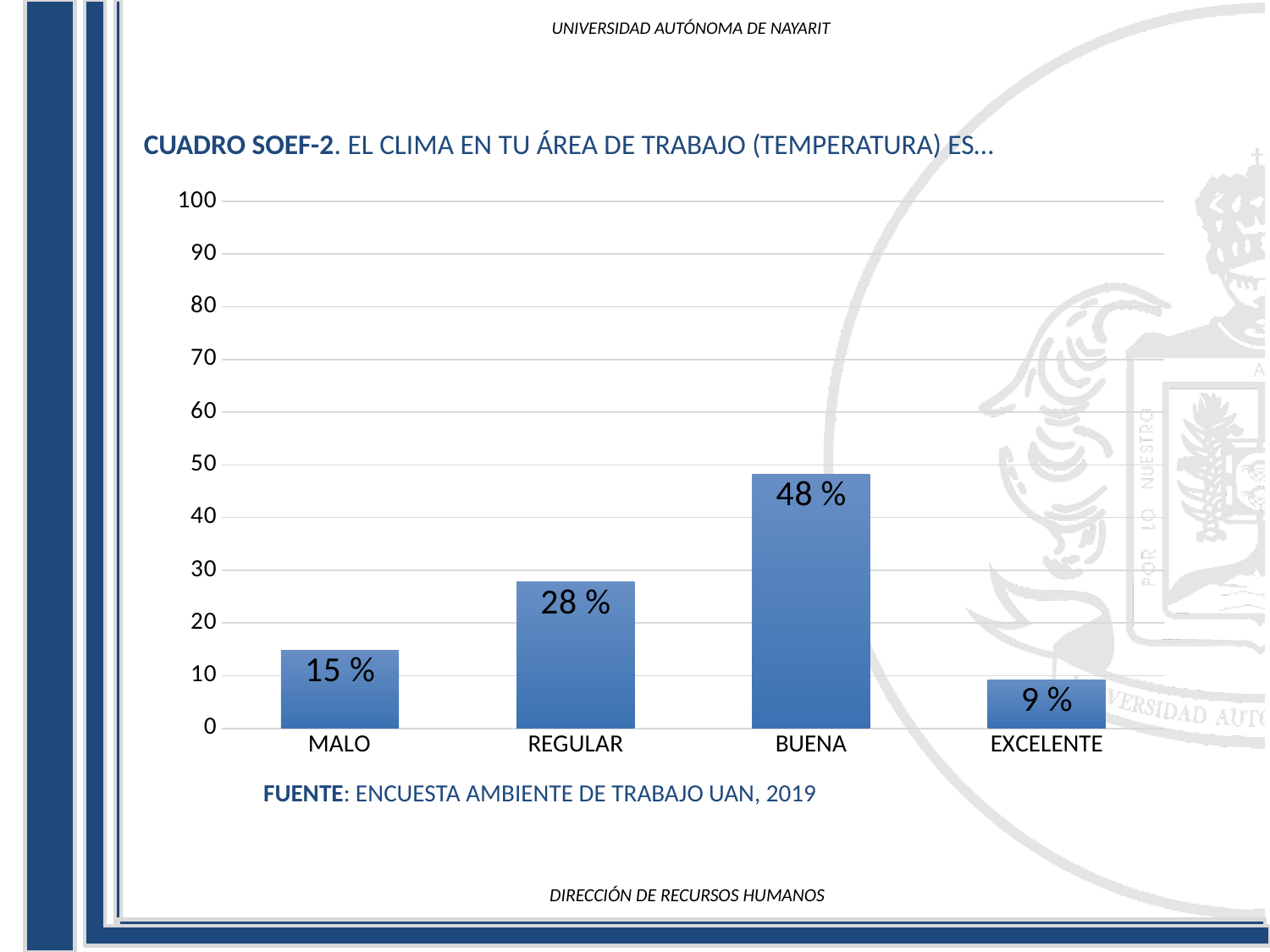
Which category has the highest value? BUENA What is the value for BUENA? 48 % What kind of chart is shown on the slide? bar chart Which is larger, the value for MALO or the value for REGULAR? REGULAR What is the value for EXCELENTE? 9 % What is the maximum value shown on the y axis? 100 Is the value for REGULAR greater or less than 30? less Which category has the lowest value? EXCELENTE What is the source cited below the chart? ENCUESTA AMBIENTE DE TRABAJO UAN, 2019 What is the value for MALO? 15 % How many categories are shown on the x axis? 4 What is the difference between the values for BUENA and REGULAR? 20 %